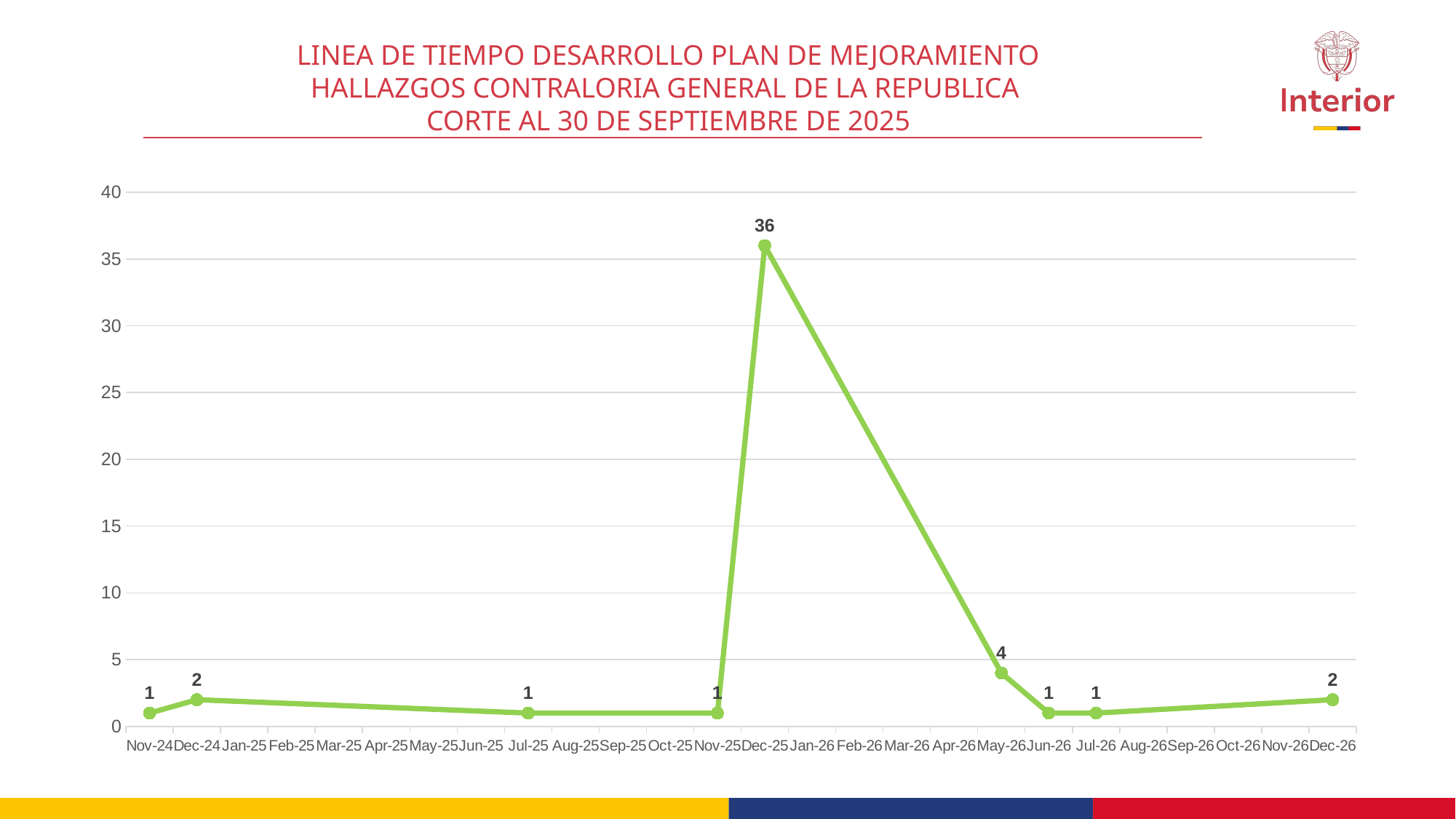
What is the value plotted for Jul-25? 1 What is the value plotted for Dec-26? 2 Which month has the highest value on the chart? Dec-25 What type of chart is shown on the slide? line chart What is the difference between the values for Dec-24 and Nov-24? 1 What is the value plotted for Dec-25? 36 Which is larger, the value for May-26 or the value for Jun-26? May-26 How many data points have value labels on the chart? 9 What is the difference between the values for Dec-25 and May-26? 32 What is the value plotted for Dec-24? 2 What is the highest value shown on the vertical axis? 40 What is the value plotted for May-26? 4